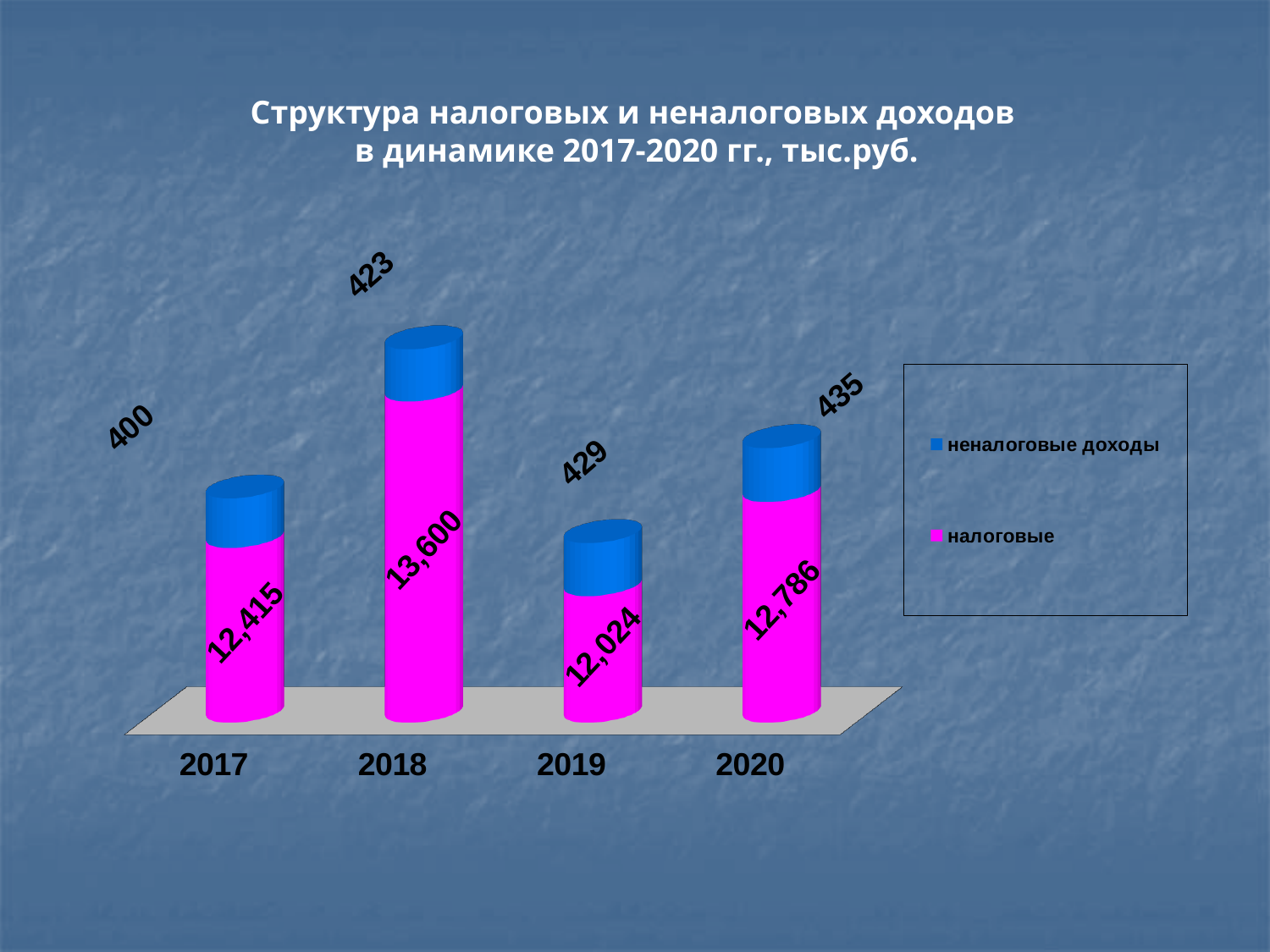
Which year has the highest value for налоговые? 2018 What is the total of the stacked bar for 2020? 13,221 What is the difference between the налоговые values for 2018 and 2019? 1,576 Which year has the lowest value for неналоговые доходы? 2017 Which is larger, the налоговые value for 2017 or for 2020? 2020 Which colour represents неналоговые доходы in the chart? Blue What is the value of неналоговые доходы for 2020? 435 What kind of chart is shown on the slide? Stacked bar chart What is the value of налоговые for 2019? 12,024 How many years are shown on the x axis? 4 How many series does the legend list? 2 What is the value of налоговые for 2018? 13,600